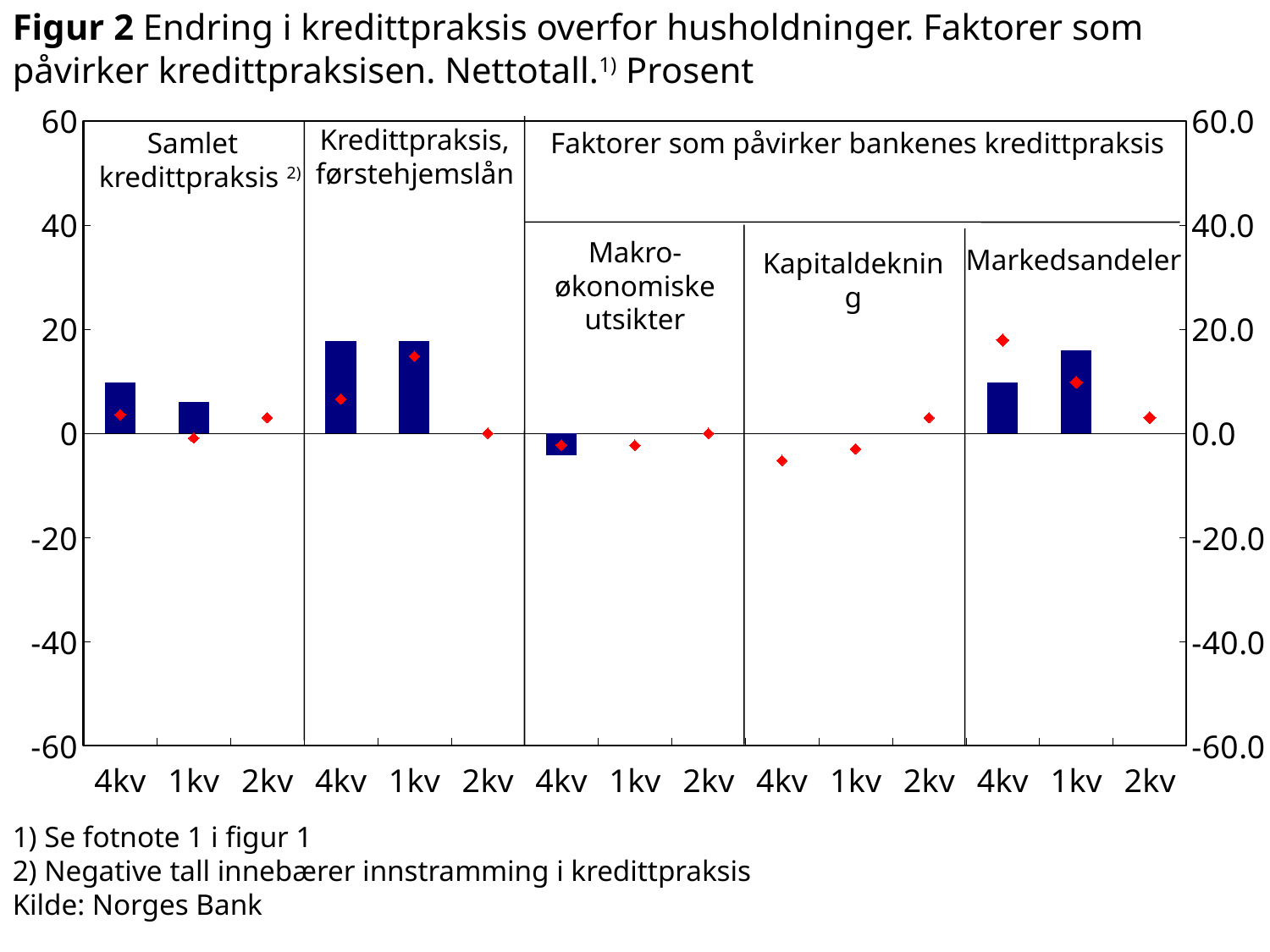
How many quarter categories are labelled along the x axis? 15 Is the bar for 4kv under Kredittpraksis, førstehjemslån greater or less than 10? greater Under Markedsandeler, which bar is taller, 4kv or 1kv? 1kv Is the red diamond for 4kv under Markedsandeler greater or less than 10? greater What kind of chart is shown on the slide? combination chart with bars and diamond markers Is the red diamond for 4kv under Kapitaldekning greater or less than 0? less How many blue bars are plotted in the chart? 7 Which section of the chart contains a bar that goes below zero? Makroøkonomiske utsikter What is the maximum value shown on the right-hand axis? 60.0 Under Samlet kredittpraksis, which bar is taller, 4kv or 1kv? 4kv Which section of the chart has no bars at all, only red diamonds? Kapitaldekning